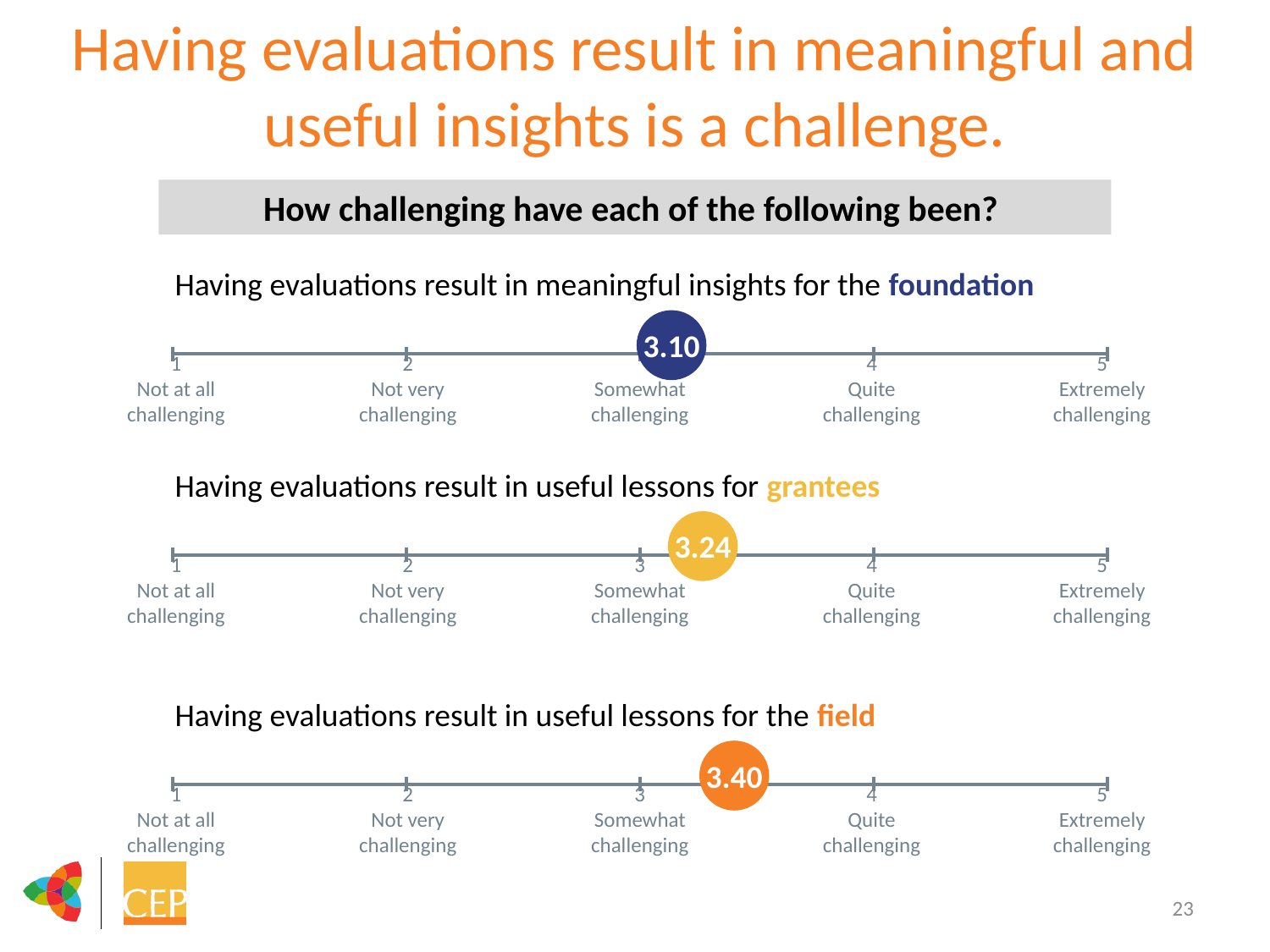
Across the three charts on the slide, which item has the lowest challenge rating? Having evaluations result in meaningful insights for the foundation On the chart for 'Having evaluations result in meaningful insights for the foundation', what is the plotted value? 3.10 On the 'field' chart, is the plotted value greater or less than 4? less Which is larger: the value on the 'grantees' chart or the value on the 'field' chart? field On the chart for 'Having evaluations result in useful lessons for the field', what is the plotted value? 3.40 Across the three charts on the slide, which item has the highest challenge rating? Having evaluations result in useful lessons for the field What is the difference between the value on the 'field' chart and the value on the 'foundation' chart? 0.30 On the 'foundation' chart, is the plotted value greater or less than 3? greater On the chart for 'Having evaluations result in useful lessons for grantees', what is the plotted value? 3.24 On each chart, what label is shown at scale point 5? Extremely challenging How many scale points are marked on the axis of each chart? 5 What is the difference between the value on the 'grantees' chart and the value on the 'foundation' chart? 0.14